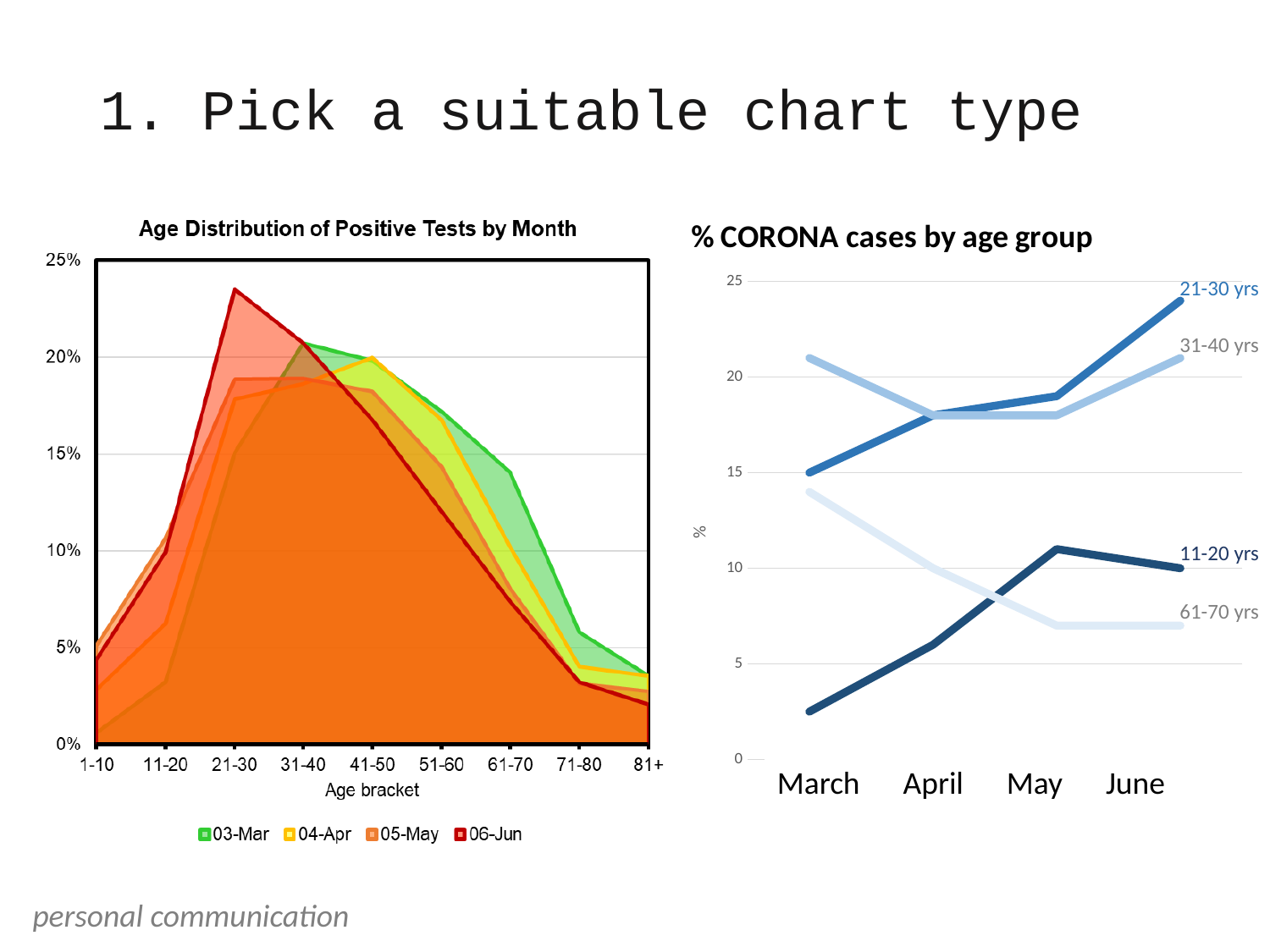
In the "% CORONA cases by age group" chart, which is larger in March: 31-40 yrs or 21-30 yrs? 31-40 yrs What type of chart is the "% CORONA cases by age group" chart on the right? line chart In the "% CORONA cases by age group" chart, is the value for 21-30 yrs in June greater or less than 20? greater In the "% CORONA cases by age group" chart, which age group has the lowest value in March? 11-20 yrs How many series does the legend of the "Age Distribution of Positive Tests by Month" chart list? 4 How many months are shown on the x axis of the "% CORONA cases by age group" chart? 4 In the "% CORONA cases by age group" chart, which age group has the highest value in June? 21-30 yrs In the "% CORONA cases by age group" chart, does the 21-30 yrs line rise or fall from March to June? rise How many age brackets are shown on the x axis of the "Age Distribution of Positive Tests by Month" chart? 9 In the "% CORONA cases by age group" chart, does the 61-70 yrs line rise or fall from March to June? fall In the "Age Distribution of Positive Tests by Month" chart, is the 06-Jun value for the 21-30 age bracket greater or less than 20%? greater In the "% CORONA cases by age group" chart, is the value for 11-20 yrs in March greater or less than 5? less